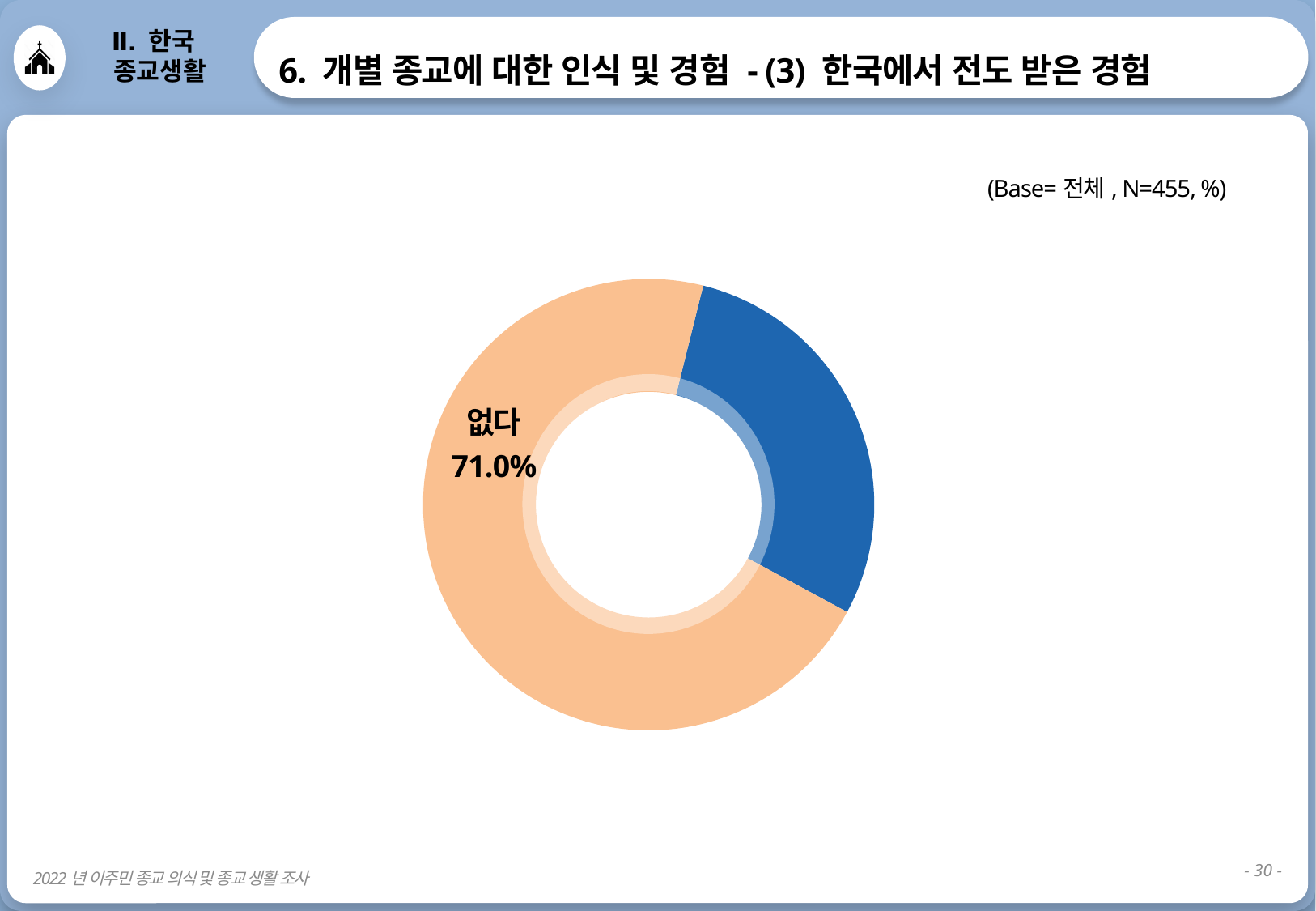
Which is larger, the 없다 slice or the blue slice? 없다 How many slices does the donut chart have? 2 What is the base sample size (N) stated for the chart? N=455 What kind of chart is shown on the slide? donut chart Which slice of the donut chart is the largest? 없다 What colour is the 없다 slice of the donut chart? orange (peach) What share of the donut chart does 없다 take? 71.0% What percentage is shown for the 없다 slice of the donut chart? 71.0%